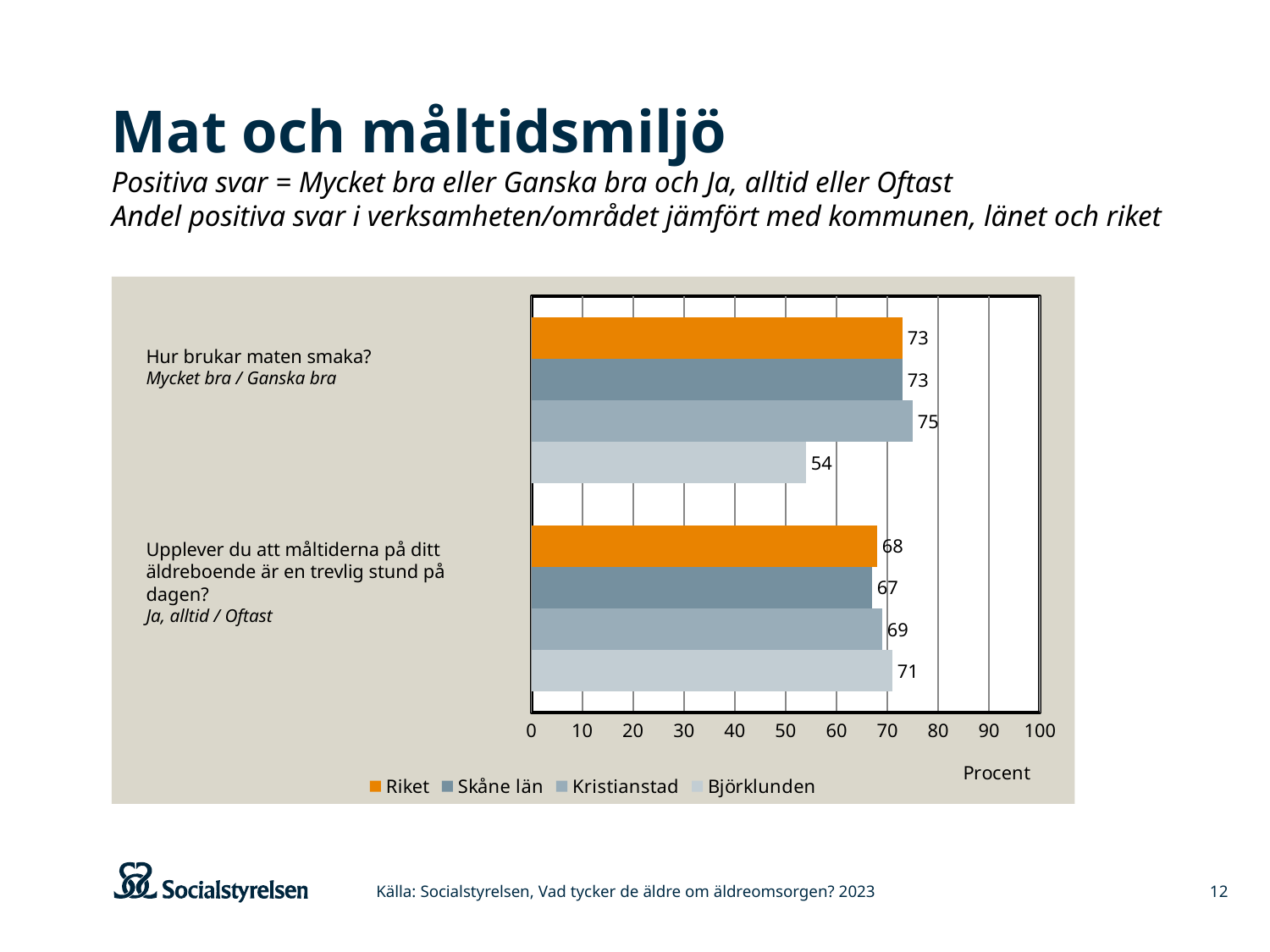
How many series does the legend list? 4 What is the value for Riket for the question "Upplever du att måltiderna på ditt äldreboende är en trevlig stund på dagen?"? 68 For the question "Upplever du att måltiderna på ditt äldreboende är en trevlig stund på dagen?", which is larger: the value for Riket or the value for Skåne län? Riket What kind of chart is shown on the slide? Bar chart What is the difference between the Kristianstad and Björklunden values for the question "Hur brukar maten smaka?"? 21 Which series has the highest value for the question "Upplever du att måltiderna på ditt äldreboende är en trevlig stund på dagen?"? Björklunden What is the value for Björklunden for the question "Hur brukar maten smaka?"? 54 What is the value for Björklunden for the question "Upplever du att måltiderna på ditt äldreboende är en trevlig stund på dagen?"? 71 Is the value for Björklunden for the question "Hur brukar maten smaka?" greater or less than 60? less Which series has the lowest value for the question "Hur brukar maten smaka?"? Björklunden What unit is shown on the x axis of the chart? Procent What is the value for Kristianstad for the question "Hur brukar maten smaka?"? 75